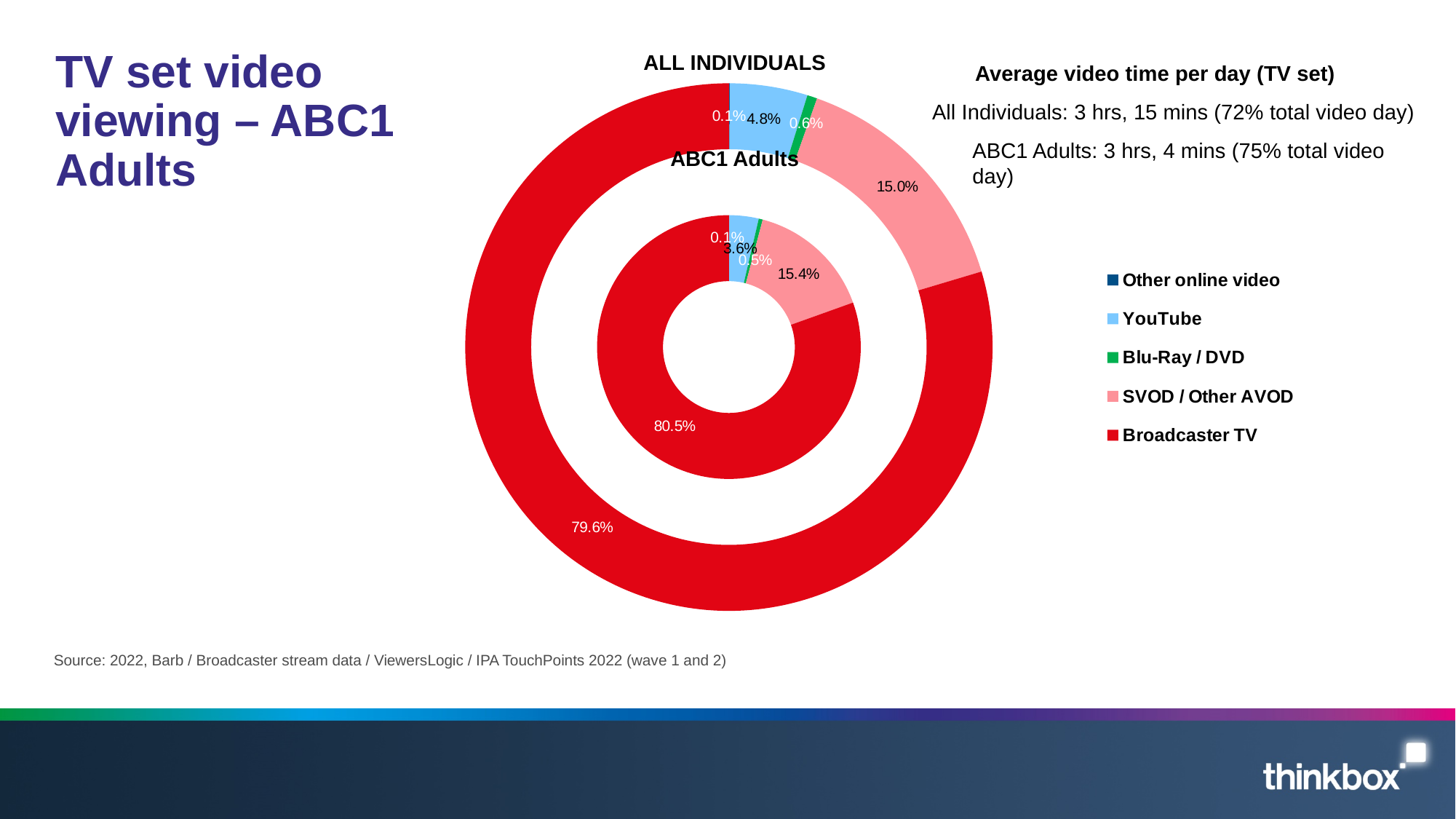
In the ALL INDIVIDUALS ring, what share does YouTube have? 4.8% In the ABC1 Adults ring, what share does Blu-Ray / DVD have? 0.5% Which colour represents Broadcaster TV in the chart? Red What type of chart is shown on the slide? Doughnut chart In the ALL INDIVIDUALS ring, what share does Broadcaster TV have? 79.6% Is the SVOD / Other AVOD share larger for ALL INDIVIDUALS or for ABC1 Adults? ABC1 Adults In the ABC1 Adults ring, what share does Broadcaster TV have? 80.5% Which category has the smallest share in the ABC1 Adults ring? Other online video How many categories does the legend list? 5 What is the difference between the YouTube share for ALL INDIVIDUALS and for ABC1 Adults? 1.2% Which category has the largest share in the ALL INDIVIDUALS ring? Broadcaster TV In the ABC1 Adults ring, what share does SVOD / Other AVOD have? 15.4%